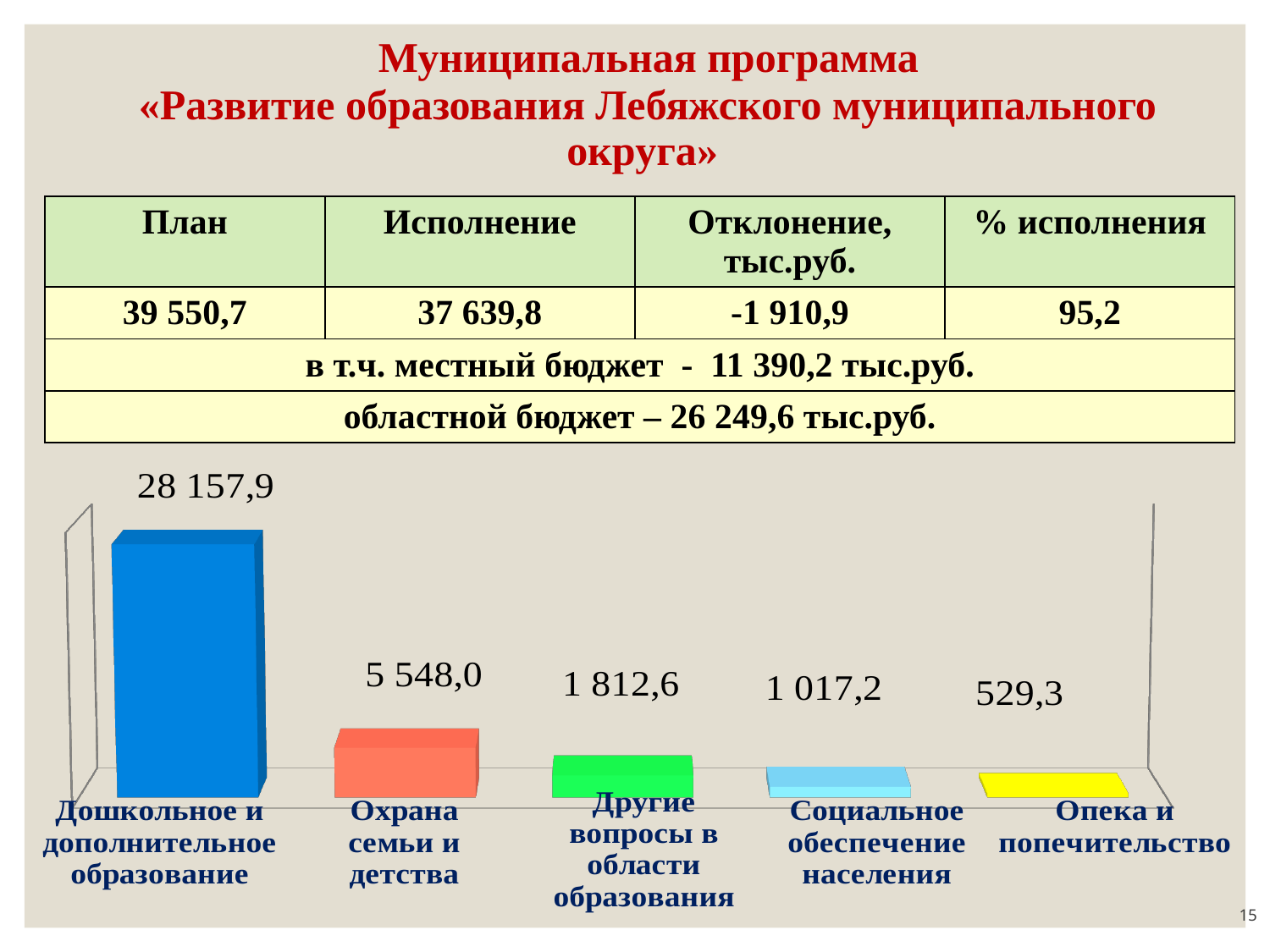
What is the difference between the values for Дошкольное и дополнительное образование and Охрана семьи и детства? 22 609,9 What is the value for Социальное обеспечение населения? 1 017,2 What kind of chart is shown on the slide? Bar chart What is the value for Охрана семьи и детства? 5 548,0 Which category has the lowest value? Опека и попечительство What is the value for Опека и попечительство? 529,3 What is the value for Дошкольное и дополнительное образование? 28 157,9 What is the value for Другие вопросы в области образования? 1 812,6 Which is larger: the value for Охрана семьи и детства or the value for Другие вопросы в области образования? Охрана семьи и детства Which category has the highest value? Дошкольное и дополнительное образование What is the difference between the values for Социальное обеспечение населения and Опека и попечительство? 487,9 How many categories are shown in the chart? 5